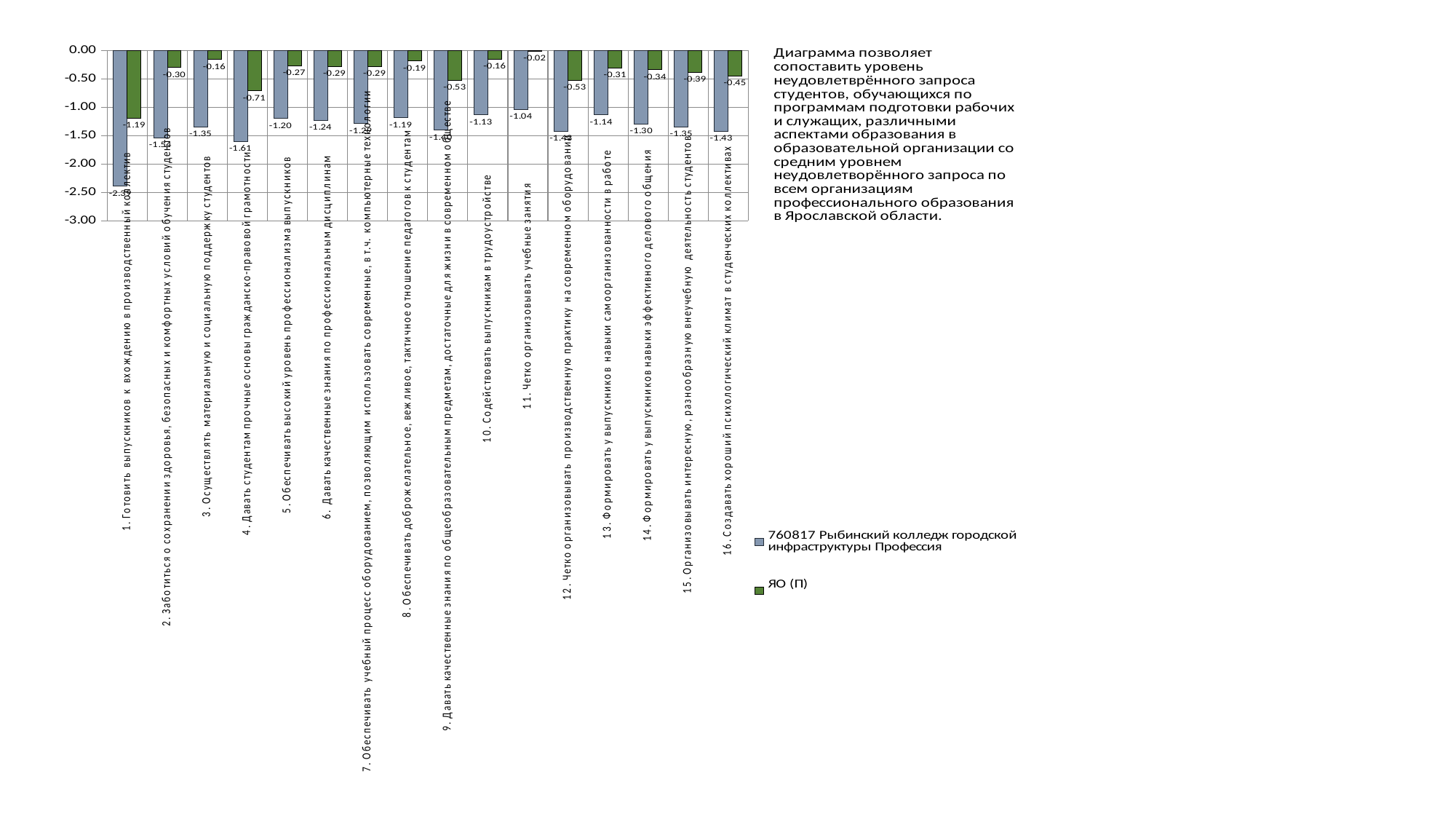
How many series does the legend list? 2 What kind of chart is shown on the slide? bar chart What is the value of the 'ЯО (П)' series for category 11 (Четко организовывать учебные занятия)? -0.02 How many categories are plotted along the x axis? 16 Which is larger, the 'ЯО (П)' value for category 4 or for category 12? category 12 (-0.53) Is the '760817 Рыбинский колледж городской инфраструктуры Профессия' value for category 1 greater or less than -2.00? less What is the difference between the two series' values for category 4 (Давать студентам прочные основы гражданско-правовой грамотности)? 0.90 What is the value of the '760817 Рыбинский колледж городской инфраструктуры Профессия' series for category 16 (Создавать хороший психологический климат в студенческих коллективах)? -1.43 What is the value of the 'ЯО (П)' series for category 4 (Давать студентам прочные основы гражданско-правовой грамотности)? -0.71 What is the value of the '760817 Рыбинский колледж городской инфраструктуры Профессия' series for category 3 (Осуществлять материальную и социальную поддержку студентов)? -1.35 For which category is the '760817 Рыбинский колледж городской инфраструктуры Профессия' value the highest (closest to zero)? 11. Четко организовывать учебные занятия For which category is the 'ЯО (П)' value the lowest (most negative)? 1. Готовить выпускников к вхождению в производственный коллектив